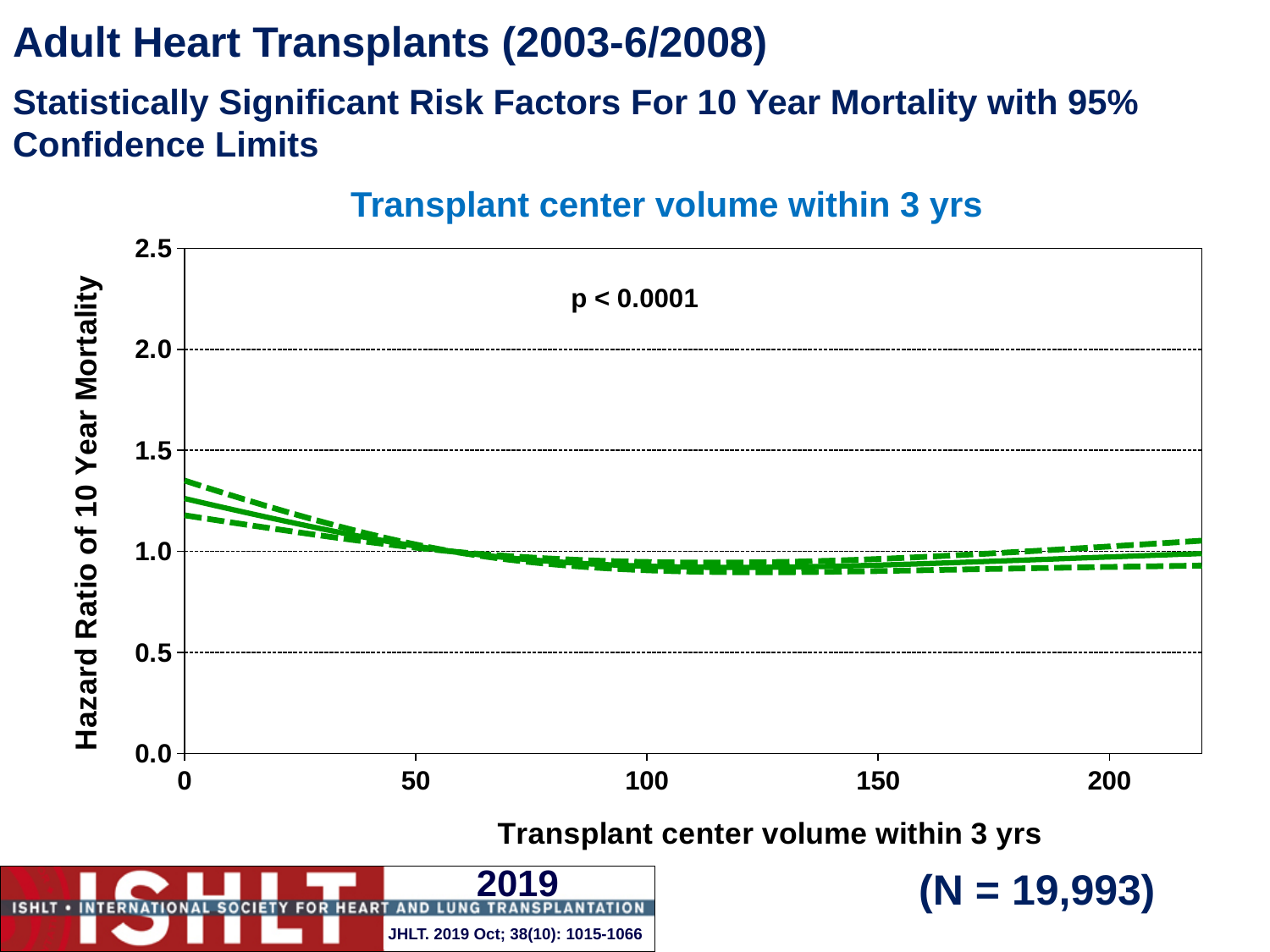
Is the hazard ratio higher at a transplant center volume of 0 or at 100? 0 What is the highest tick value shown on the x axis? 200 Is the hazard ratio at a transplant center volume of 0 greater or less than 1.5? less Is the hazard ratio at a transplant center volume of 150 greater or less than 0.5? greater Does the hazard ratio rise or fall as transplant center volume increases from 0 to 100? fall What is the highest value shown on the y axis? 2.5 Is the hazard ratio at a transplant center volume of 100 greater or less than 1.0? less What kind of chart is shown on the slide? line chart What is the title of the chart? Transplant center volume within 3 yrs How many lines are plotted on the chart (including the confidence limit lines)? 3